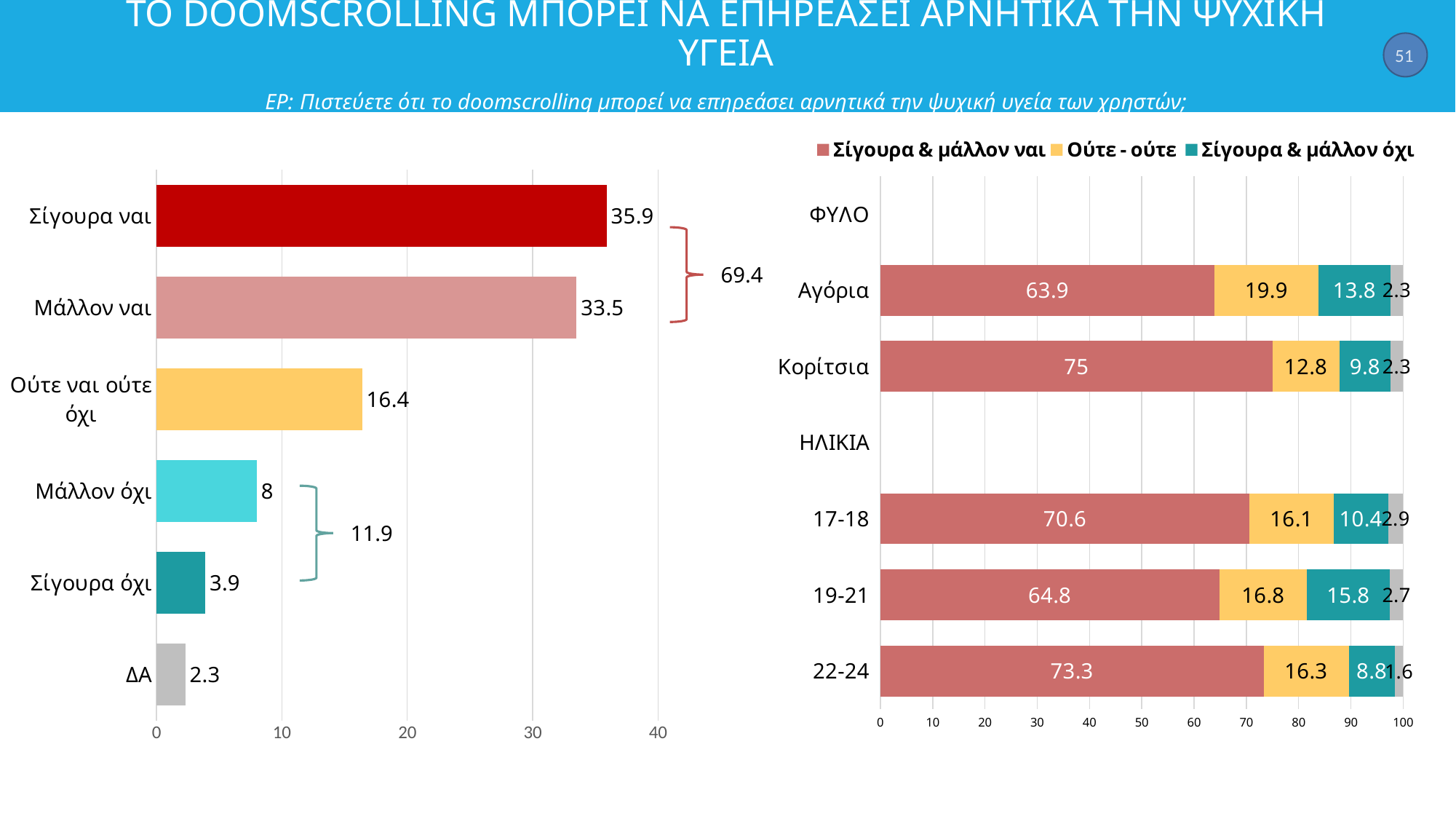
In the left chart, what is the value for Σίγουρα ναι? 35.9 What kind of chart is the left chart? Bar chart In the left chart, which category has the lowest value? ΔΑ In the left chart, what is the difference between Σίγουρα ναι and Μάλλον ναι? 2.4 In the left chart, how many categories are plotted? 6 How many series does the legend of the right chart list? 3 In the left chart, what is the value for Μάλλον όχι? 8 In the right chart, which category has the highest Σίγουρα & μάλλον ναι value? Κορίτσια In the right chart, what is the difference between the Σίγουρα & μάλλον ναι values for 22-24 and 17-18? 2.7 In the right chart, what is the Σίγουρα & μάλλον ναι value for Κορίτσια? 75 In the right chart, which is larger: the Σίγουρα & μάλλον όχι value for Αγόρια or for Κορίτσια? Αγόρια In the right chart, what is the Ούτε - ούτε value for 19-21? 16.8